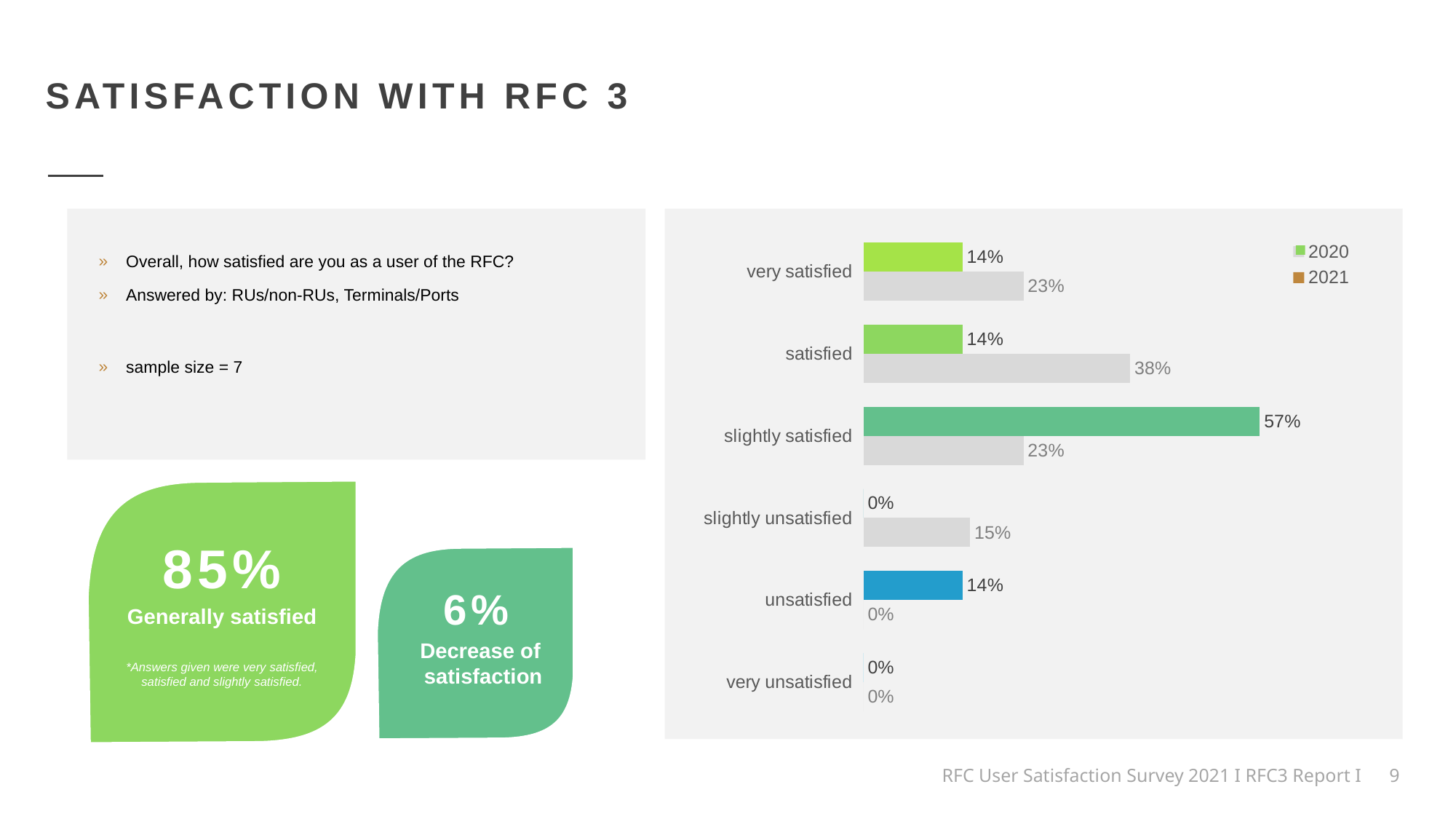
What value is shown on the grey (lower) bar for 'slightly unsatisfied'? 15% Which two series are listed in the chart legend? 2020 and 2021 Which category has the highest value among the grey (lower) bars? satisfied For 'very satisfied', which is larger: the coloured (upper) bar or the grey (lower) bar? the grey (lower) bar What is the difference between the coloured bar (57%) and the grey bar (23%) for 'slightly satisfied'? 34% What value is shown on the coloured (upper) bar for 'unsatisfied'? 14% What type of chart is shown on the slide? bar chart What value is shown on the grey (lower) bar for 'satisfied'? 38% How many satisfaction categories are shown on the chart? 6 Which category has the highest value among the coloured (upper) bars? slightly satisfied What value is shown on the coloured (upper) bar for 'slightly satisfied'? 57% How many series does the chart legend list? 2